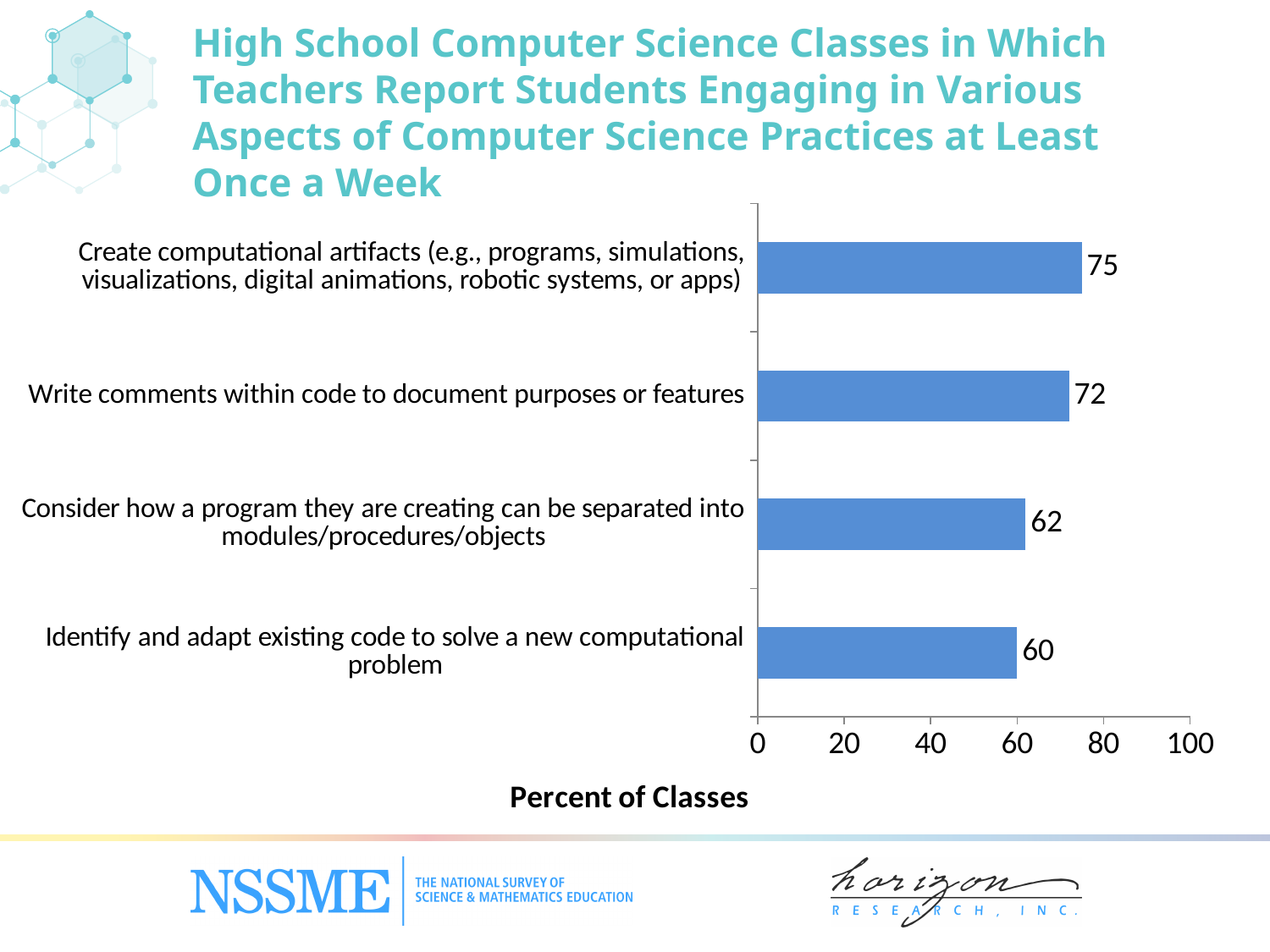
Which category has the highest percent of classes? Create computational artifacts (e.g., programs, simulations, visualizations, digital animations, robotic systems, or apps) What percent of classes report students creating computational artifacts at least once a week? 75 What is the difference between the value for writing comments within code and the value for considering how a program can be separated into modules? 10 What is the value for 'Identify and adapt existing code to solve a new computational problem'? 60 How many categories are shown in the chart? 4 Which category has the lowest percent of classes? Identify and adapt existing code to solve a new computational problem What is the label of the horizontal axis? Percent of Classes Which is larger: the value for writing comments within code or the value for considering how a program can be separated into modules/procedures/objects? Write comments within code to document purposes or features What kind of chart is shown on the slide? Bar chart What is the value for 'Write comments within code to document purposes or features'? 72 What is the value for 'Consider how a program they are creating can be separated into modules/procedures/objects'? 62 What is the difference between the value for creating computational artifacts and the value for identifying and adapting existing code? 15